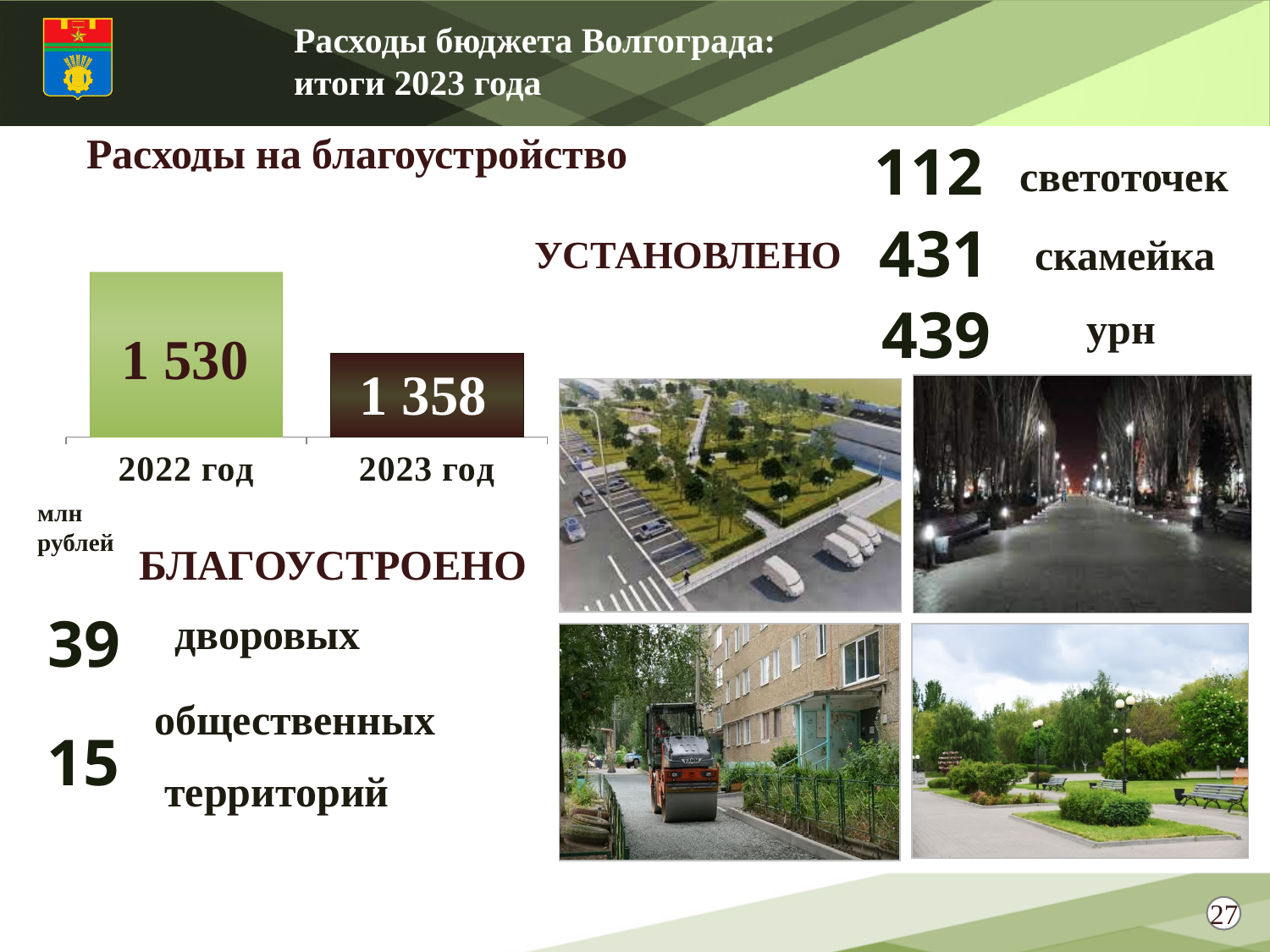
What is the value for 2023 год in the chart? 1 358 Is the value for 2023 год larger or smaller than the value for 2022 год? smaller Which year has the lower value in the chart? 2023 год In what units are the chart values given? млн рублей What is the value for 2022 год in the chart? 1 530 How many bars are shown in the chart? 2 Do the values rise or fall from 2022 год to 2023 год? fall What is the title of the chart? Расходы на благоустройство Which year has the higher value in the chart? 2022 год What is the difference between the values for 2022 год and 2023 год? 172 What kind of chart is shown on the slide? bar chart